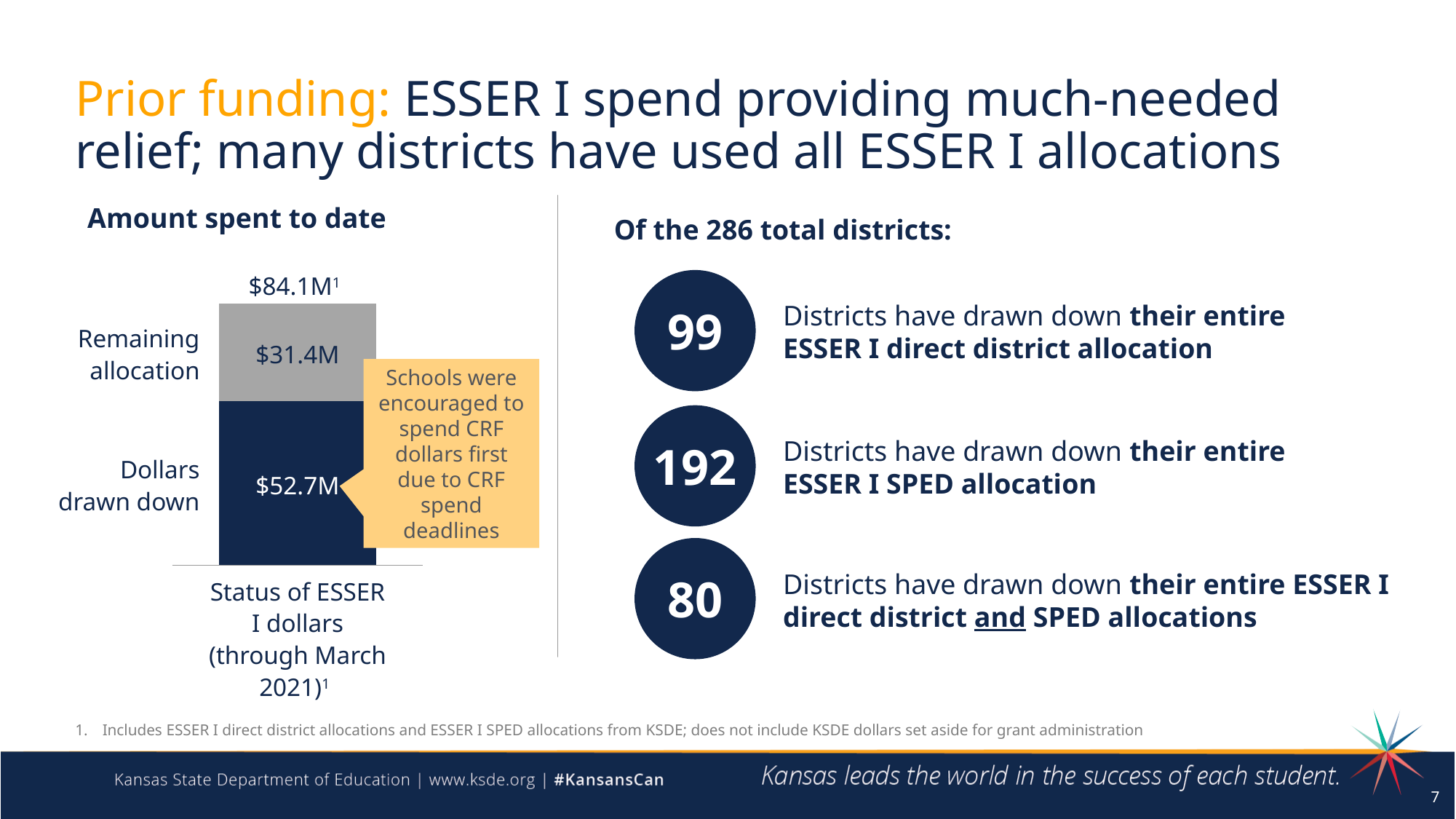
What is the value of the "Dollars drawn down" segment in the "Amount spent to date" chart? $52.7M In the "Amount spent to date" chart, which segment has the smallest value? Remaining allocation How many segments make up the bar in the "Amount spent to date" chart? 2 In the "Amount spent to date" chart, what is the difference between "Dollars drawn down" and "Remaining allocation"? $21.2M What kind of chart is the "Amount spent to date" chart? Stacked bar chart What is the category label on the x axis of the "Amount spent to date" chart? Status of ESSER I dollars (through March 2021) How many bars are plotted in the "Amount spent to date" chart? 1 In the "Amount spent to date" chart, which segment is larger: "Dollars drawn down" or "Remaining allocation"? Dollars drawn down In the "Amount spent to date" chart, which segment is shown in gray? Remaining allocation What is the total of the stacked bar in the "Amount spent to date" chart? $84.1M In the "Amount spent to date" chart, which segment has the largest value? Dollars drawn down What is the value of the "Remaining allocation" segment in the "Amount spent to date" chart? $31.4M